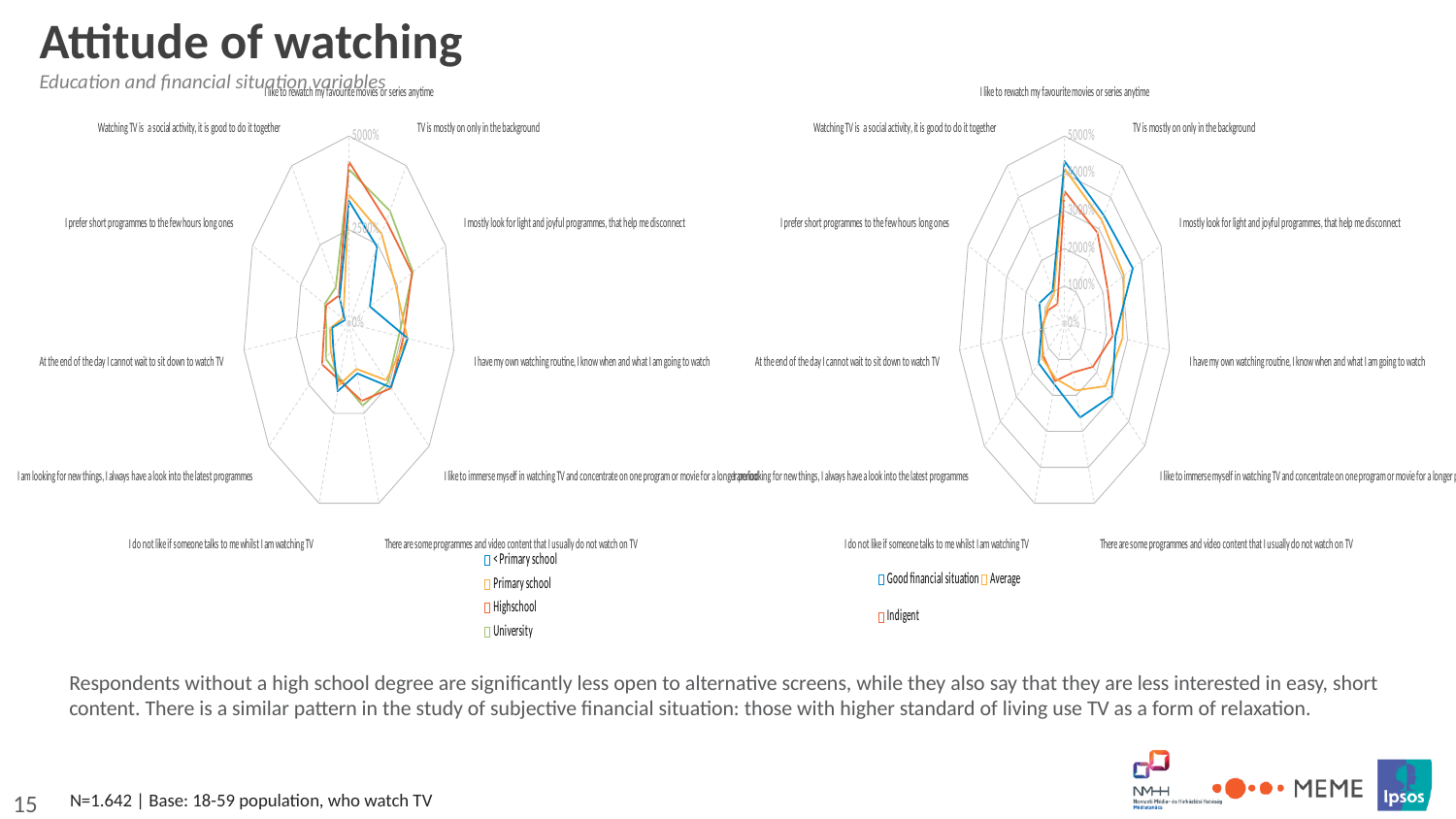
In the right chart, for which category does the Good financial situation series reach its highest value? I like to rewatch my favourite movies or series anytime What is the highest value shown on the axis scale of the left radar chart? 5000% How many series does the legend of the left chart list? 4 How many series does the legend of the right chart list? 3 How many categories (axes) does the left radar chart have? 11 What kind of chart is the left chart on the slide? Radar chart What kind of chart is the right chart on the slide? Radar chart How many categories (axes) does the right radar chart have? 11 Which series are listed in the legend of the right chart? Good financial situation, Average, Indigent Which series are listed in the legend of the left chart? < Primary school, Primary school, Highschool, University